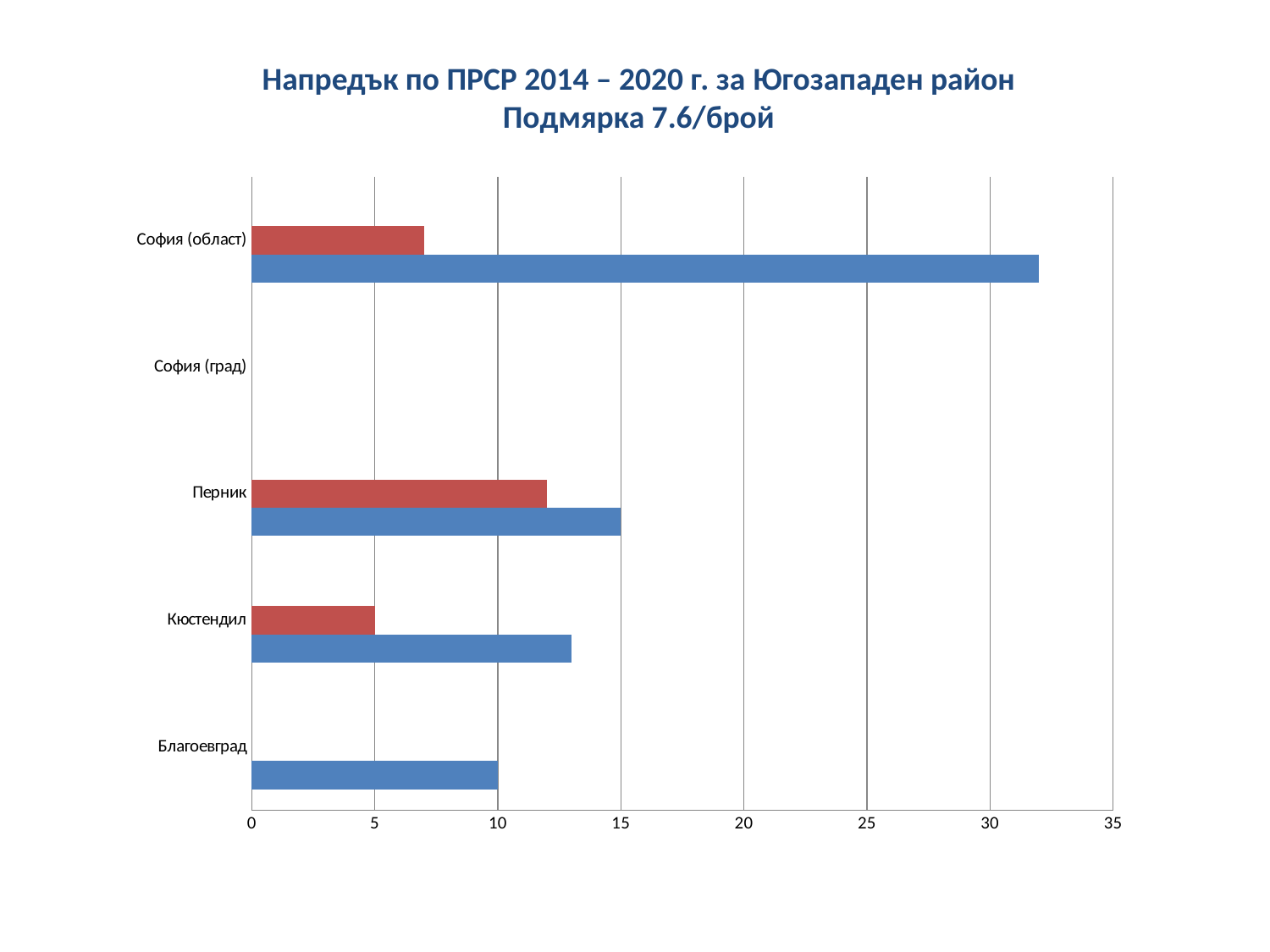
What is the value of the blue bar for Благоевград? 10 Which is larger for Кюстендил, the blue bar or the red bar? the blue bar Which category shows no bars at all? София (град) Which category has the longest blue bar? София (област) Is the red bar for София (област) greater or less than 10? less What is the title of the chart? Напредък по ПРСР 2014 – 2020 г. за Югозападен район Подмярка 7.6/брой Is the red bar for Перник greater or less than 10? greater What is the value of the blue bar for Перник? 15 How many categories are listed on the vertical axis of the chart? 5 What kind of chart is shown on the slide? bar chart What is the value of the red bar for Кюстендил? 5 Is the blue bar for София (област) greater or less than 30? greater